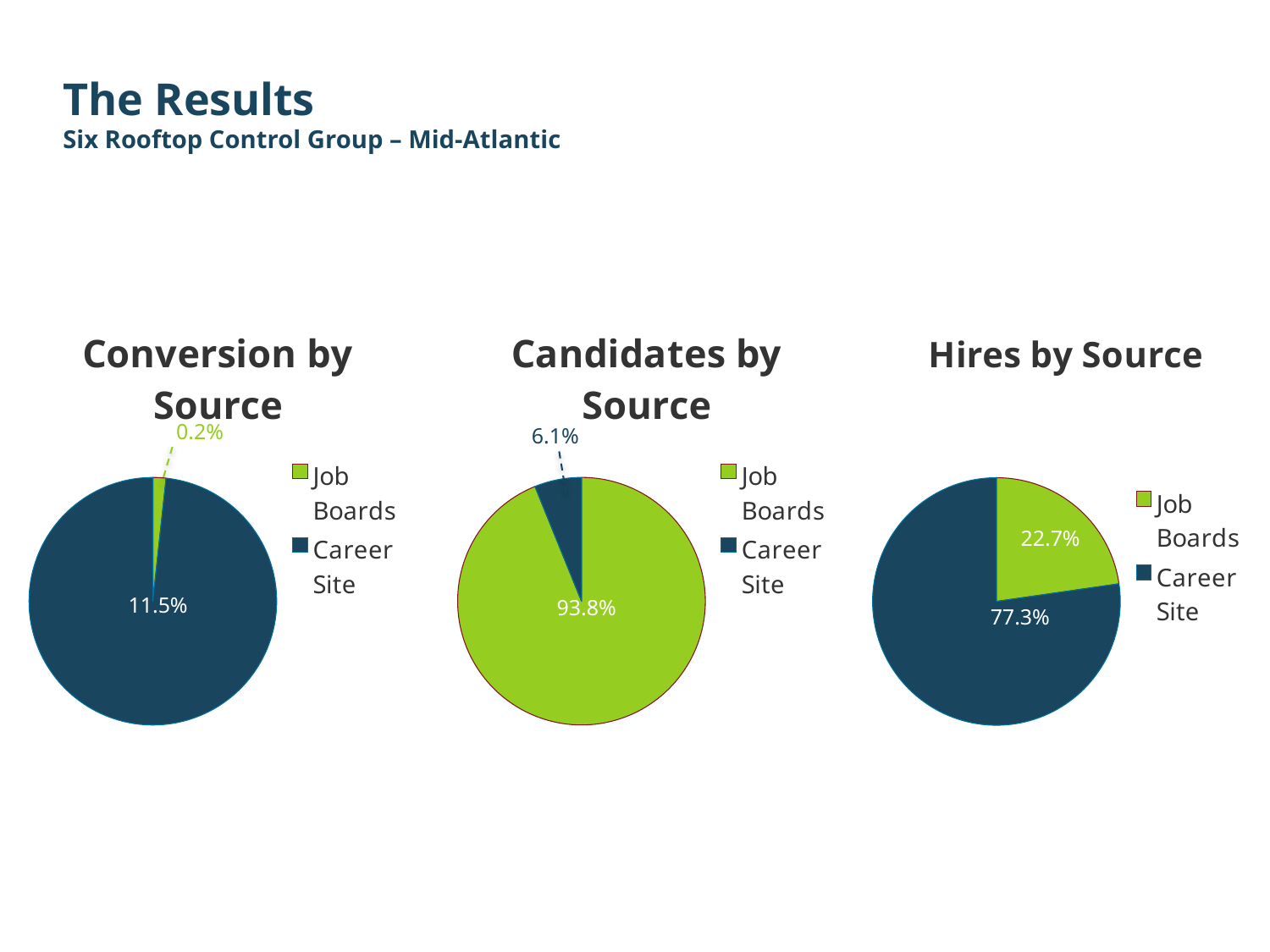
In the Hires by Source chart, what value is shown for Career Site? 77.3% In the Candidates by Source chart, is the Job Boards slice larger or smaller than the Career Site slice? larger In the Conversion by Source chart, what value is shown for Career Site? 11.5% In the Candidates by Source chart, what value is shown for Job Boards? 93.8% In the Hires by Source chart, which source has the larger slice? Career Site In the Conversion by Source chart, what value is shown for Job Boards? 0.2% How many entries does the legend of the Conversion by Source chart list? 2 In the Candidates by Source chart, what value is shown for Career Site? 6.1% In the Hires by Source chart, what value is shown for Job Boards? 22.7% In the Hires by Source chart, what is the difference in percentage points between Career Site and Job Boards? 54.6 percentage points What type of chart is used for Hires by Source? pie chart In the Candidates by Source chart, which source has the smaller slice? Career Site